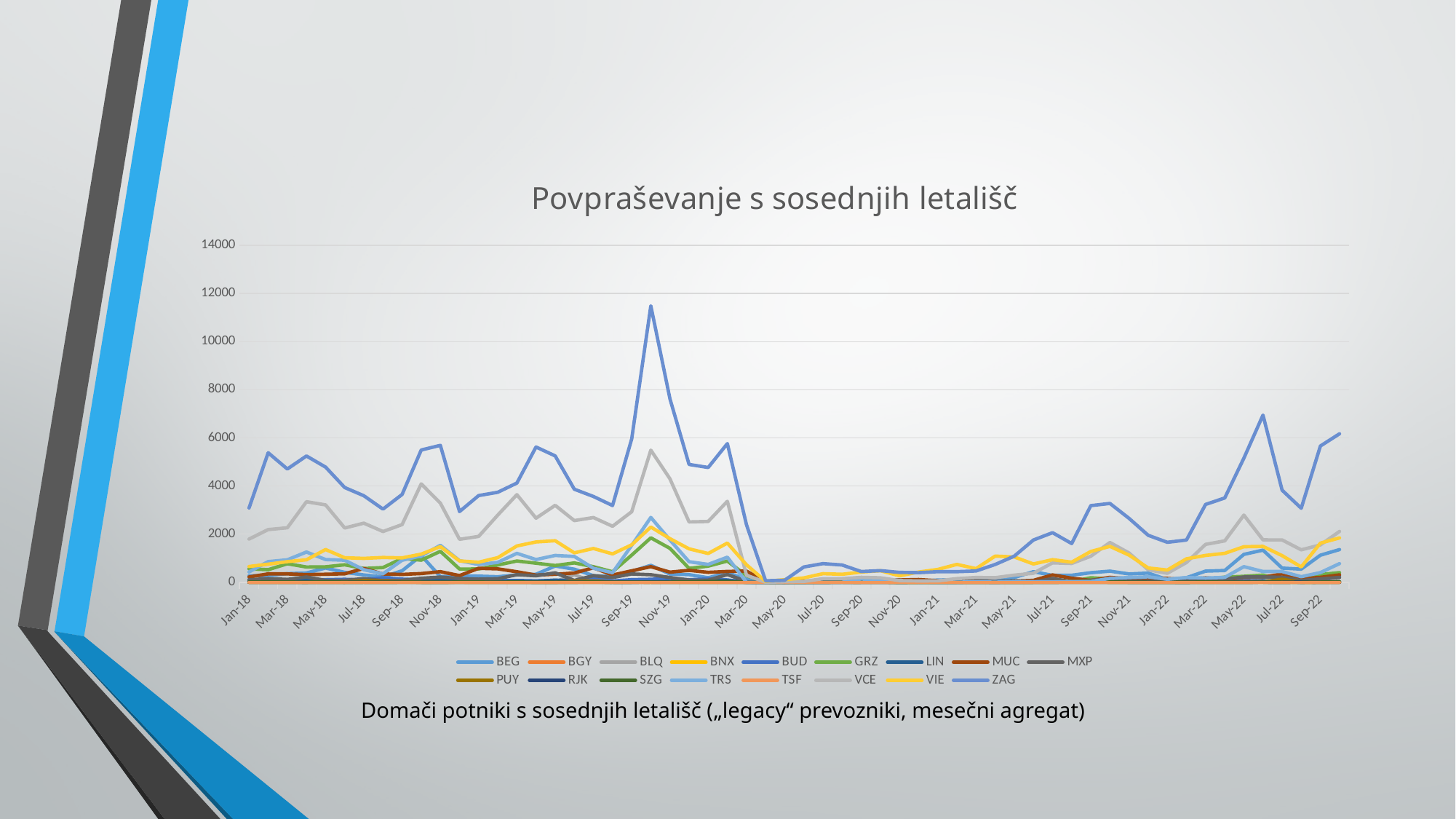
What is the title of the chart? Povpraševanje s sosednjih letališč Is the value of the top line at Jan-18 greater or less than 2000? greater What kind of chart is shown on the slide? line chart What is the first month label on the horizontal axis? Jan-18 Between which two labelled months does the top line reach its highest peak? Sep-19 and Nov-19 Is the value of the top line at May-20 greater or less than 2000? less Is the highest peak of the top line greater or less than 12000? less What is the highest value shown on the vertical axis? 14000 What is the last month label on the horizontal axis? Sep-22 How many series does the legend list? 17 Do the lines rise or fall between Mar-20 and May-20? fall